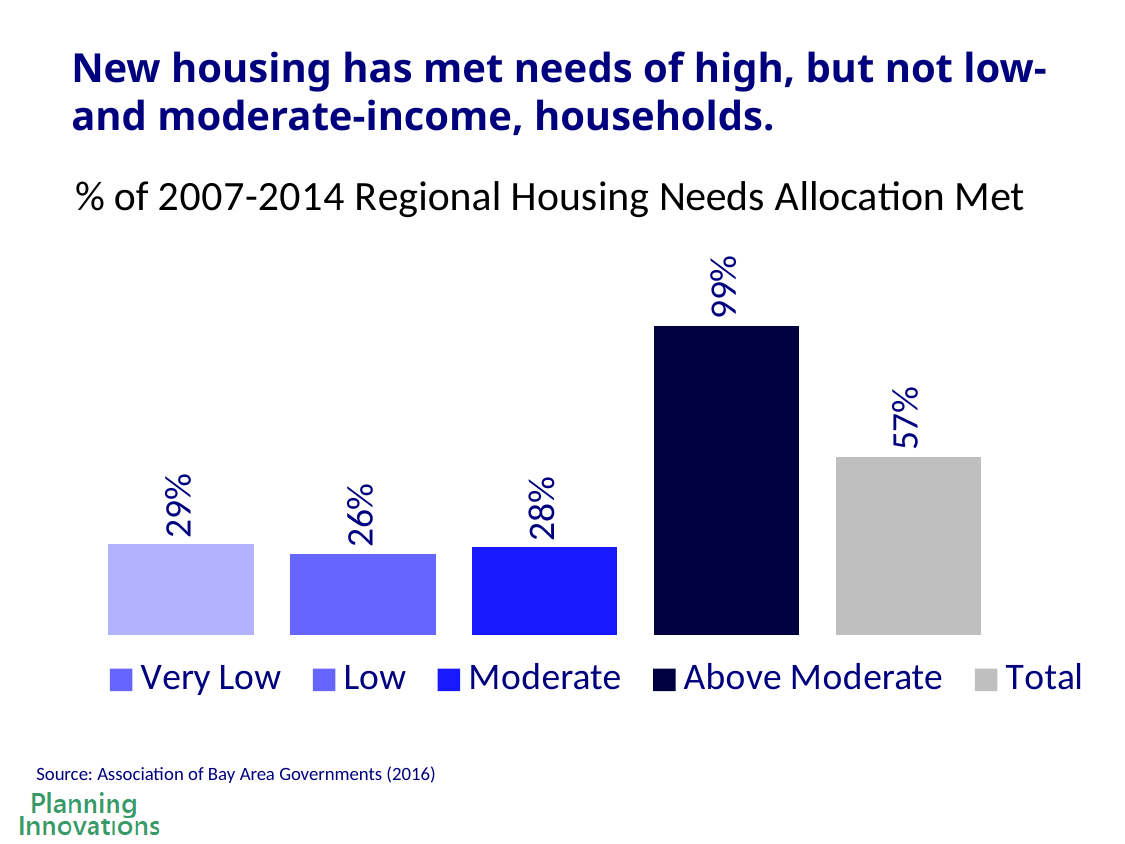
How many entries does the legend list? 5 What is the value shown for the Total bar? 57% What type of chart is shown on the slide? Bar chart Which category has the highest percentage of housing needs allocation met? Above Moderate What is the difference between the Above Moderate value and the Total value? 42% Which category has the lowest percentage of housing needs allocation met? Low What is the difference between the Very Low value and the Low value? 3% Which is larger, the value for Moderate or the value for Total? Total What percentage of the Regional Housing Needs Allocation was met for the Above Moderate category? 99% How many bars are plotted in the chart? 5 What is the value shown for the Moderate category? 28% What percentage of the Regional Housing Needs Allocation was met for the Very Low category? 29%